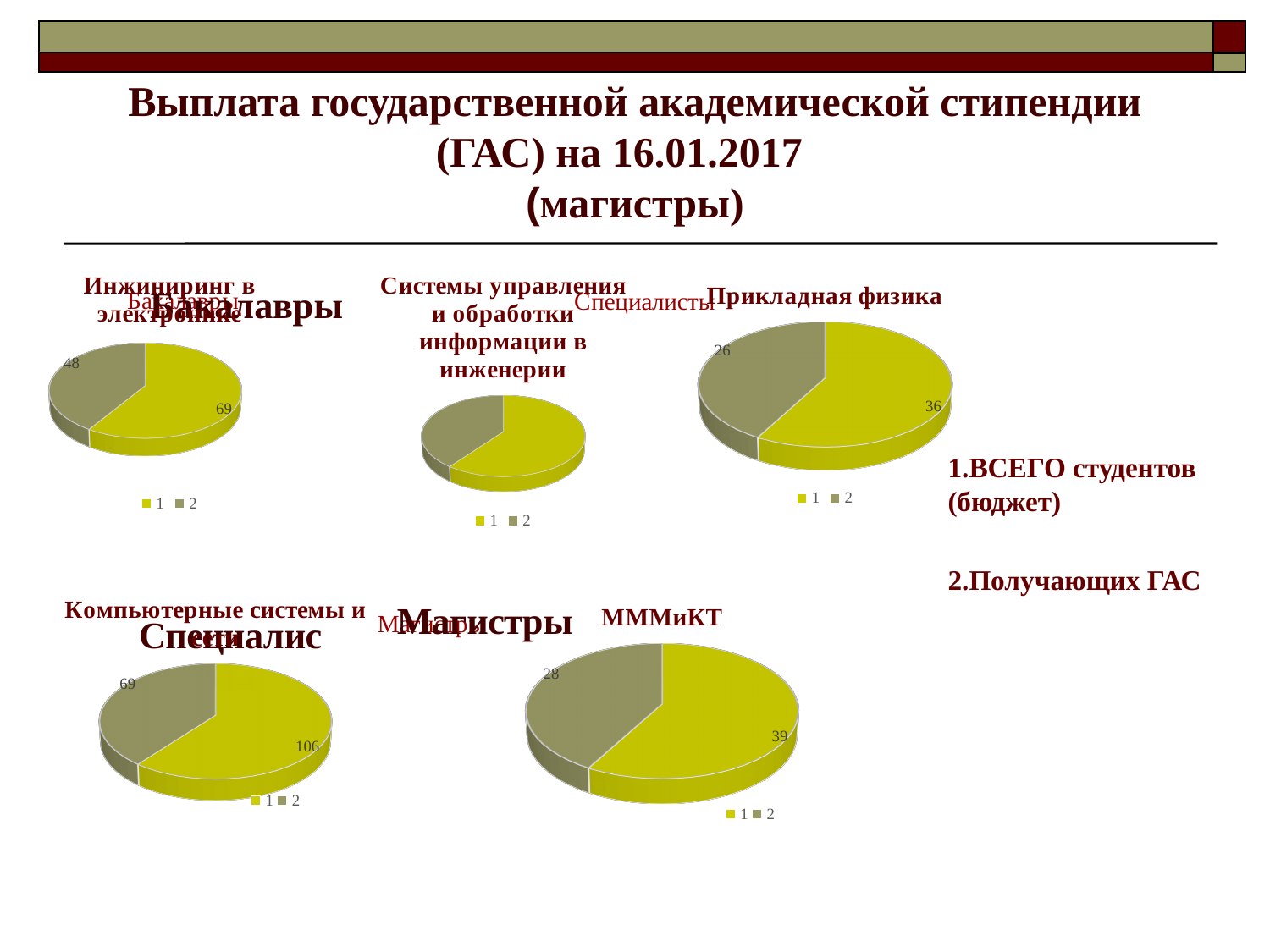
In the pie chart titled "Прикладная физика", what is the value of the larger (yellow) slice? 36 In the top-left pie chart (Инжиниринг в электронике), what is the value of the smaller slice? 48 In the bottom-left pie chart (Компьютерные системы и сети), what is the difference between the two slice values, 106 and 69? 37 In the bottom-left pie chart (Компьютерные системы и сети), what is the value of the larger slice? 106 How many entries does the legend of the "МММиКТ" pie chart list? 2 In the pie chart titled "Прикладная физика", what is the value of the smaller (olive) slice? 26 In the pie chart titled "МММиКТ", what is the value of the larger slice? 39 In the pie chart titled "Прикладная физика", what is the total of the two slices, 36 and 26? 62 What kind of chart is used for "Прикладная физика"? Pie chart In the pie chart titled "МММиКТ", what is the value of the smaller slice? 28 How many pie charts are shown on the slide? 5 In the pie chart titled "МММиКТ", which slice is larger, the one labelled 39 or the one labelled 28? 39